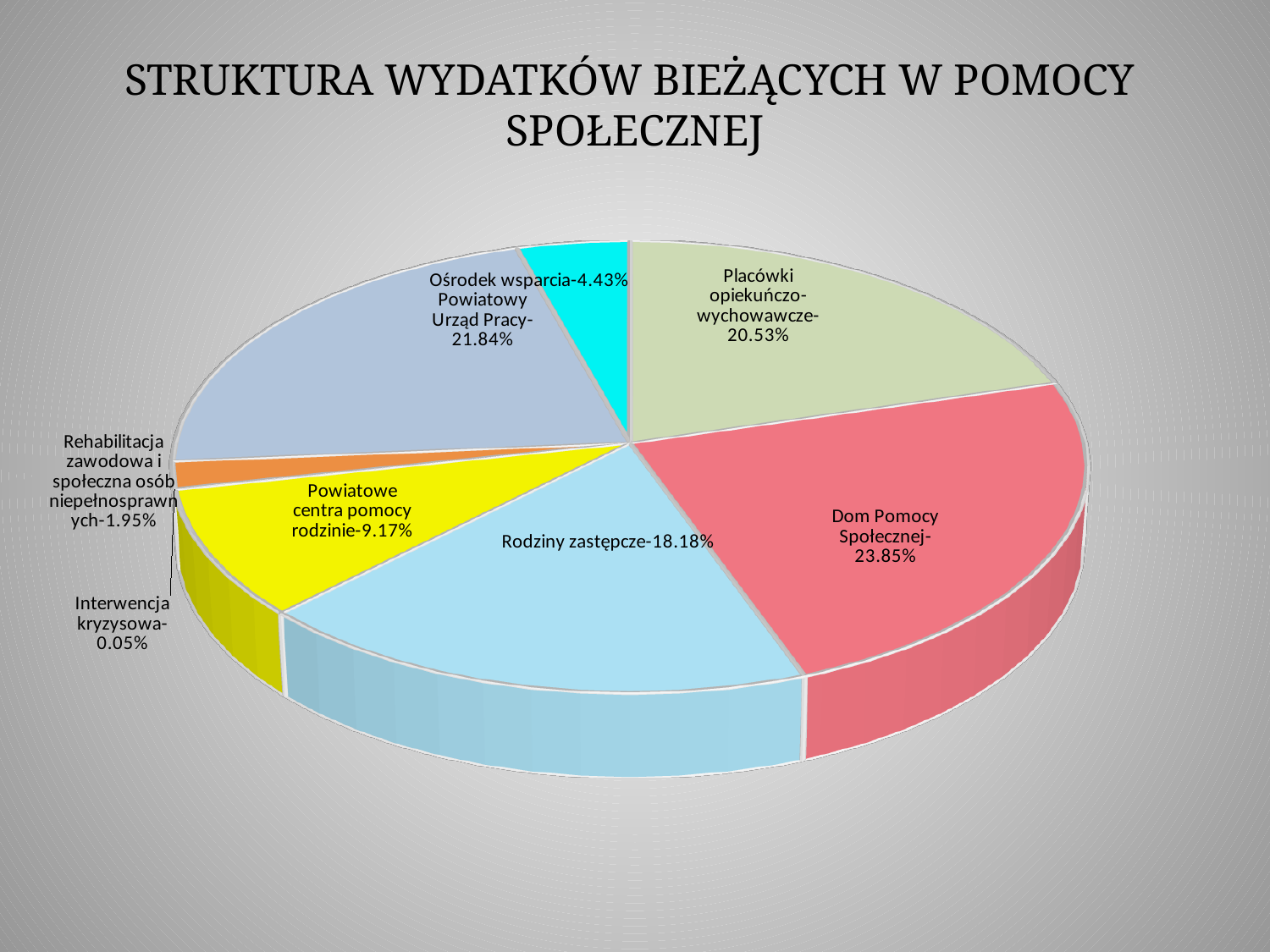
What percentage is shown for Ośrodek wsparcia? 4.43% What is the difference in percentage points between Dom Pomocy Społecznej and Placówki opiekuńczo-wychowawcze? 3.32 What share of current social assistance expenditure goes to Dom Pomocy Społecznej? 23.85% What is the value labelled for Rodziny zastępcze? 18.18% What percentage is shown for Powiatowy Urząd Pracy? 21.84% What share is shown for Interwencja kryzysowa? 0.05% Which is larger: the share for Powiatowy Urząd Pracy or the share for Placówki opiekuńczo-wychowawcze? Powiatowy Urząd Pracy Which category has the smallest share of the pie? Interwencja kryzysowa What type of chart is shown on the slide? Pie chart What is the title of the chart? STRUKTURA WYDATKÓW BIEŻĄCYCH W POMOCY SPOŁECZNEJ Which category has the largest share of the pie? Dom Pomocy Społecznej How many slices does the pie chart have? 8